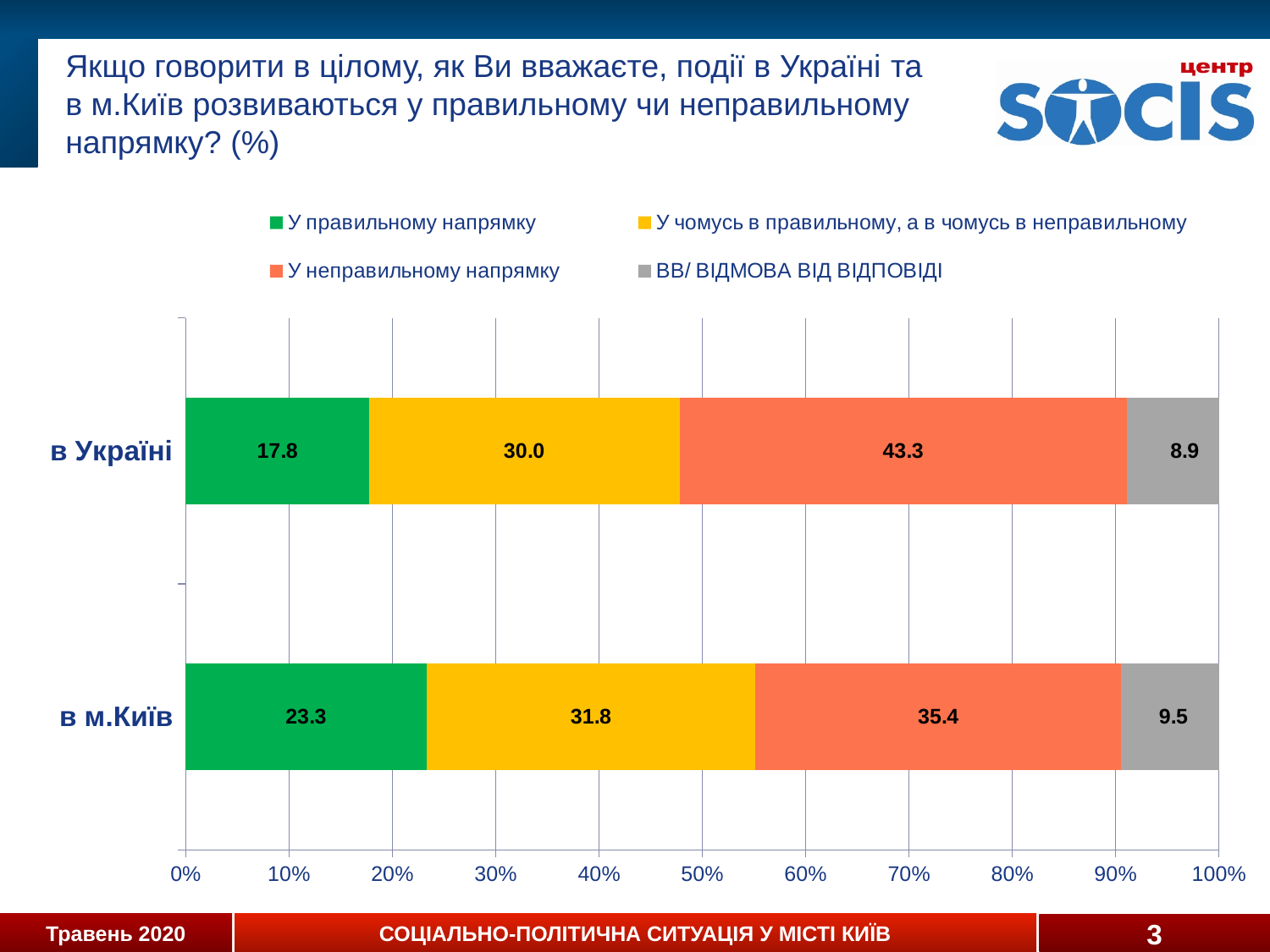
What is the value for "У чомусь в правильному, а в чомусь в неправильному" for "в м.Київ"? 31.8 What kind of chart is shown on the slide? Stacked bar chart What is the value for "У неправильному напрямку" for "в м.Київ"? 35.4 Which series has the largest value in the "в Україні" bar? У неправильному напрямку What is the difference between the "У неправильному напрямку" values for "в Україні" and "в м.Київ"? 7.9 What is the value for "У правильному напрямку" for "в Україні"? 17.8 How many categories (bars) does the chart show? 2 Which category has the larger value for "У правильному напрямку", "в Україні" or "в м.Київ"? в м.Київ What colour represents "У неправильному напрямку" in the chart? Orange Which series has the smallest value in the "в м.Київ" bar? ВВ/ ВІДМОВА ВІД ВІДПОВІДІ How many series does the legend list? 4 What is the value for "ВВ/ ВІДМОВА ВІД ВІДПОВІДІ" for "в Україні"? 8.9